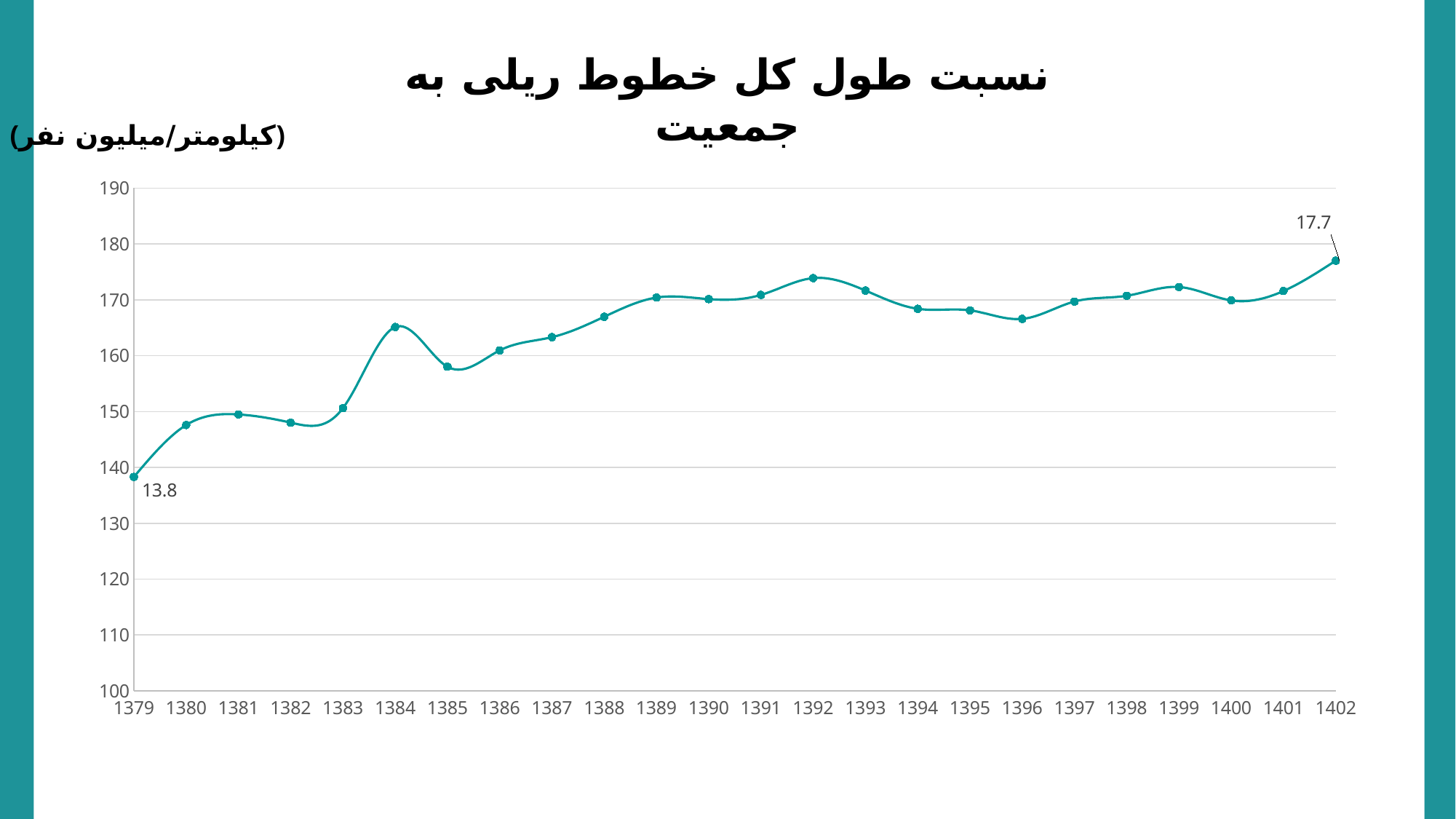
How many years are plotted on the x axis? 24 Which year has the lowest value on the chart? 1379 Is the value for 1392 greater or less than 170? greater Is the value for 1396 greater or less than 170? less Is the value for 1384 greater or less than 160? greater What kind of chart is shown on the slide? Line chart What is the data label shown for the year 1379? 13.8 What is the data label shown for the year 1402? 17.7 Which year has the larger value, 1384 or 1385? 1384 Which year has the larger value, 1392 or 1396? 1392 Do the values generally rise or fall from 1379 to 1402? Rise Which year has the highest value on the chart? 1402